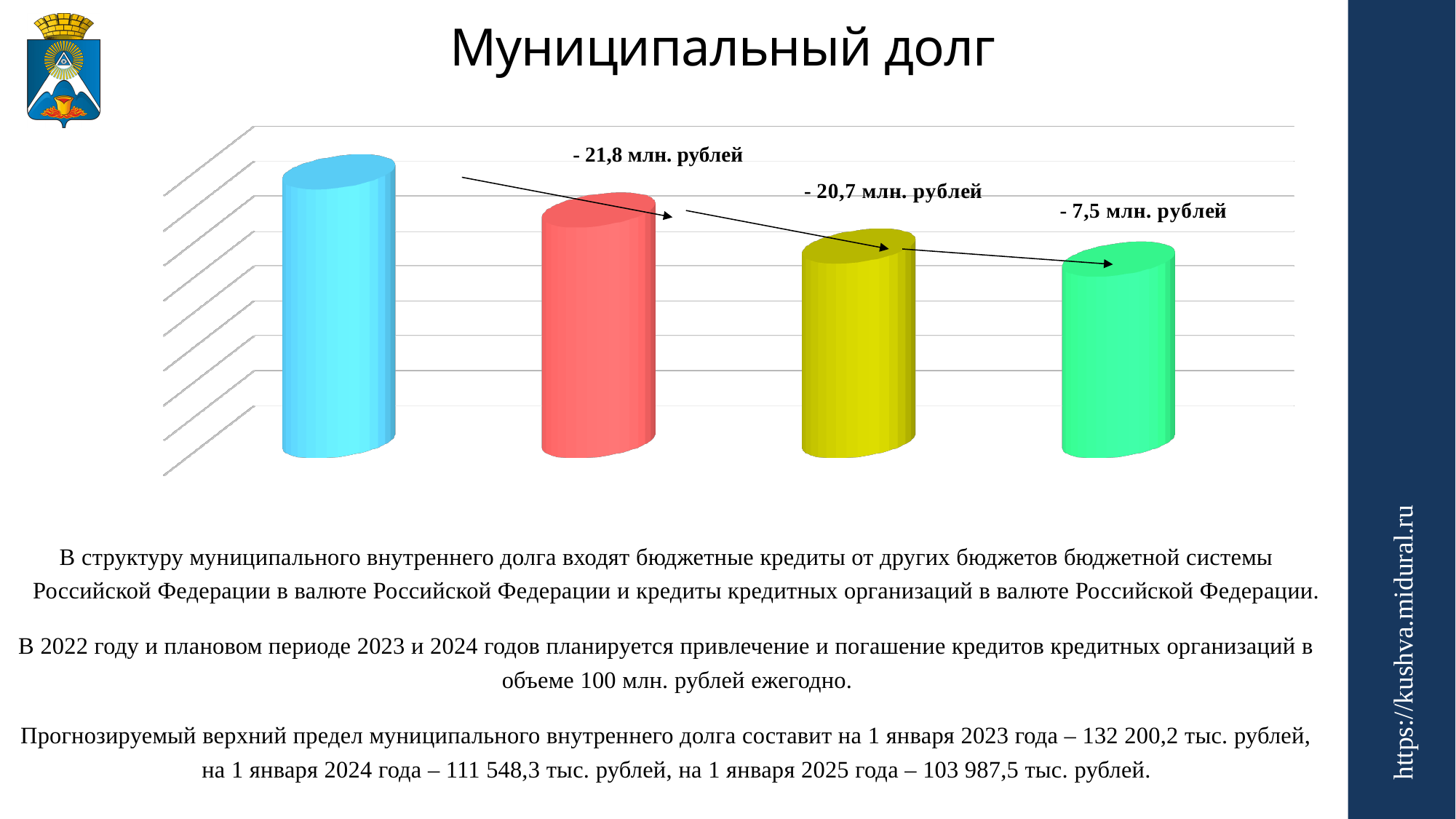
What is the title of the slide containing the chart? Муниципальный долг How many bars does the chart contain? 4 What colour is the third bar in the chart? yellow Which bar is the shortest in the chart? the fourth (green) bar What kind of chart is shown on the slide? bar chart Which is taller, the blue bar or the green bar? the blue bar Which is taller, the red bar or the yellow bar? the red bar What decrease is labelled on the arrow between the first and second bars? - 21,8 млн. рублей Do the bar heights rise or fall from left to right across the chart? fall What decrease is labelled on the arrow between the second and third bars? - 20,7 млн. рублей What decrease is labelled on the arrow between the third and fourth bars? - 7,5 млн. рублей Which bar is the tallest in the chart? the first (blue) bar